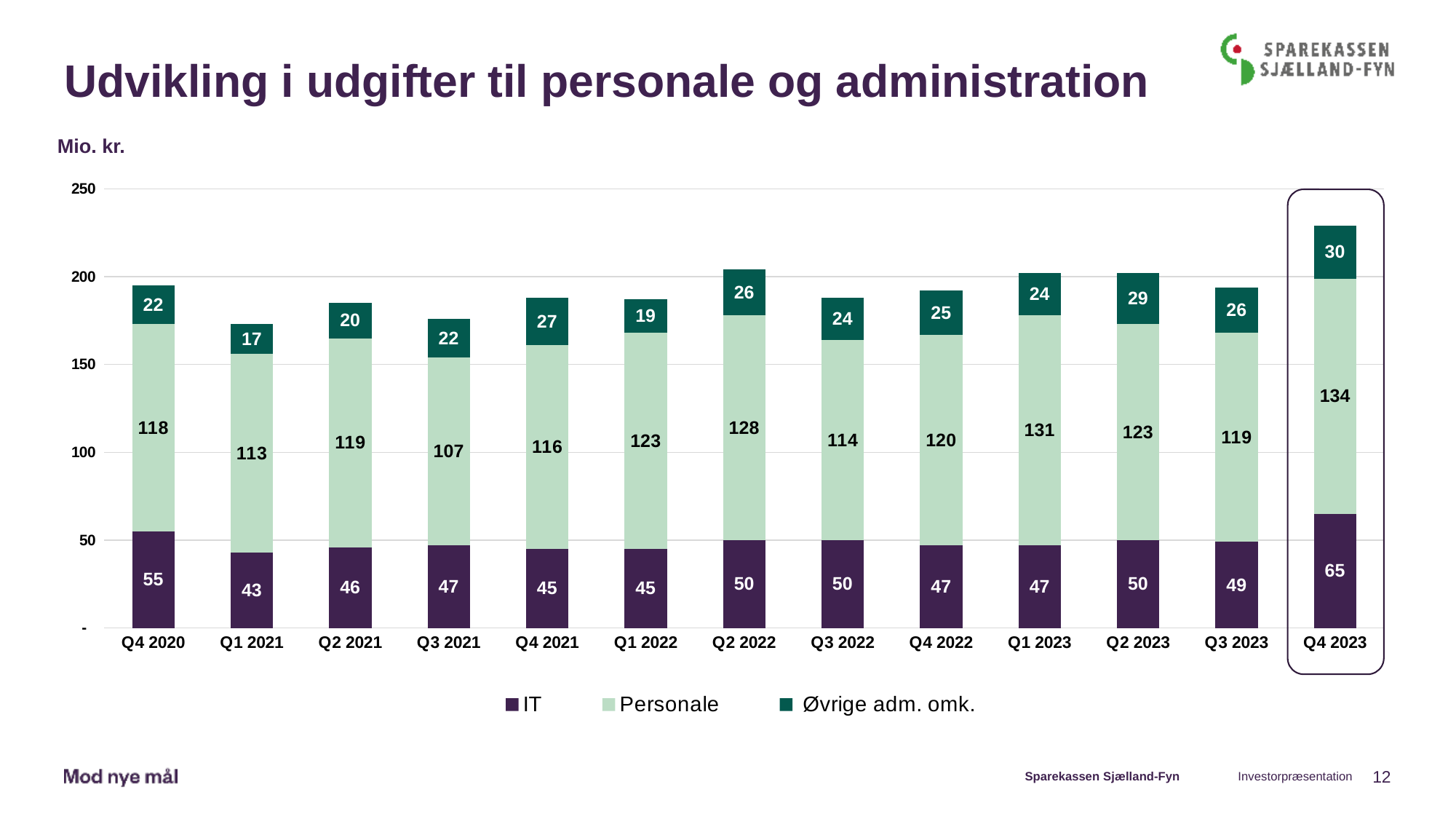
Which quarter has the lowest IT value? Q1 2021 What is the Personale value for Q2 2022? 128 What is the difference between the Personale values for Q4 2023 and Q3 2023? 15 What is the Øvrige adm. omk. value for Q1 2021? 17 What kind of chart is shown on the slide? Stacked bar chart What is the total of the stacked bar for Q1 2021? 173 What is the IT value for Q4 2023? 65 Which is larger, the Øvrige adm. omk. value for Q2 2023 or for Q1 2023? Q2 2023 What is the total of the stacked bar for Q4 2023? 229 Which quarter has the highest Personale value? Q4 2023 How many quarters are shown on the x axis? 13 How many series does the legend list? 3